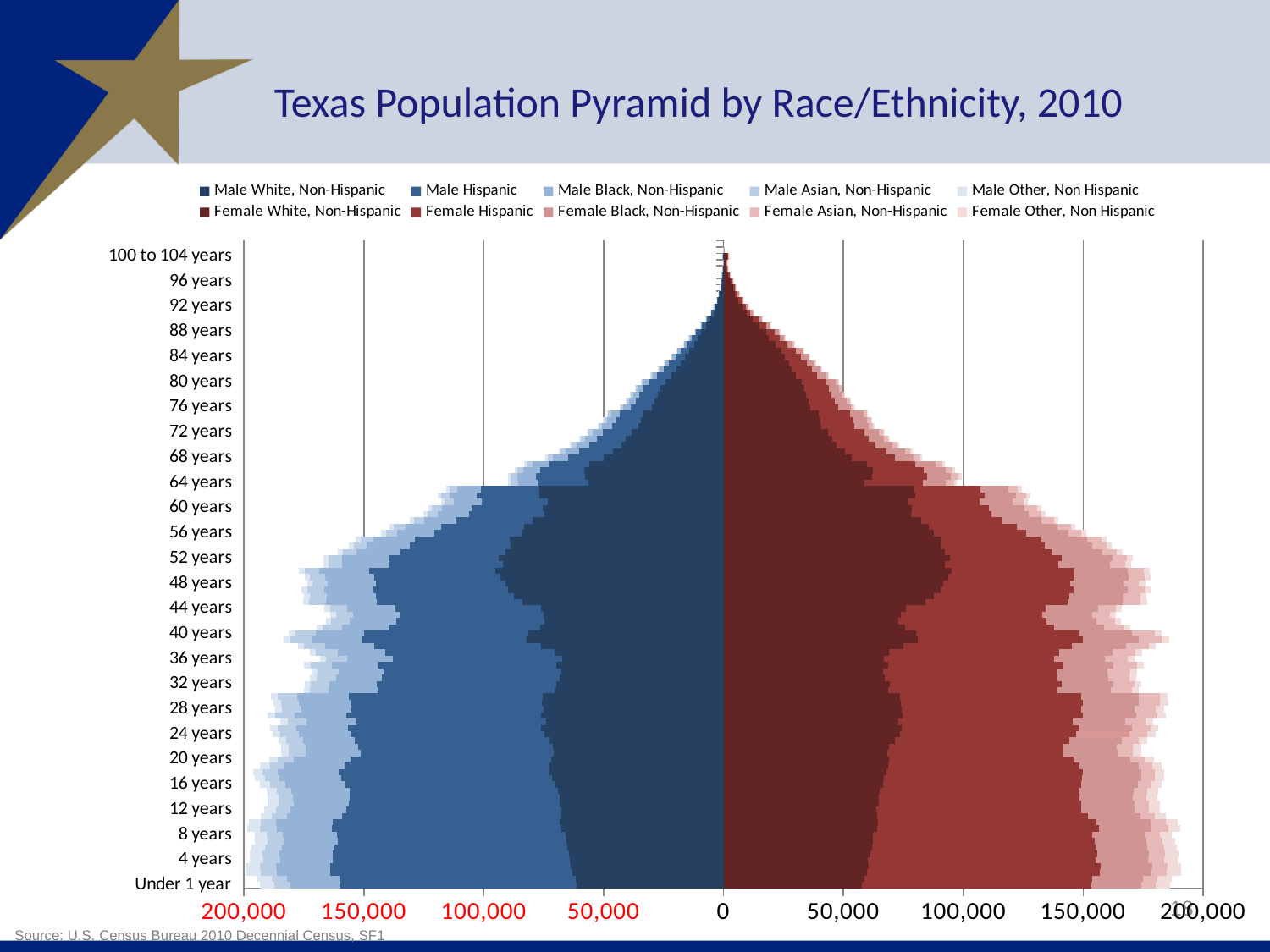
Is the total male bar for 40 years greater or less than 150,000? greater At 84 years, is the total male bar or the total female bar longer? Female What kind of chart is shown on the slide? Bar chart (population pyramid) Is the total female bar for 84 years greater or less than 50,000? less Is the total male bar for Under 1 year greater or less than 150,000? greater How many series does the legend list? 10 Which colour family is used for the male series and which for the female series? Male in blue, female in red Do the total bar lengths generally rise or fall as age increases from Under 1 year to 100 to 104 years? fall What is the title of the chart? Texas Population Pyramid by Race/Ethnicity, 2010